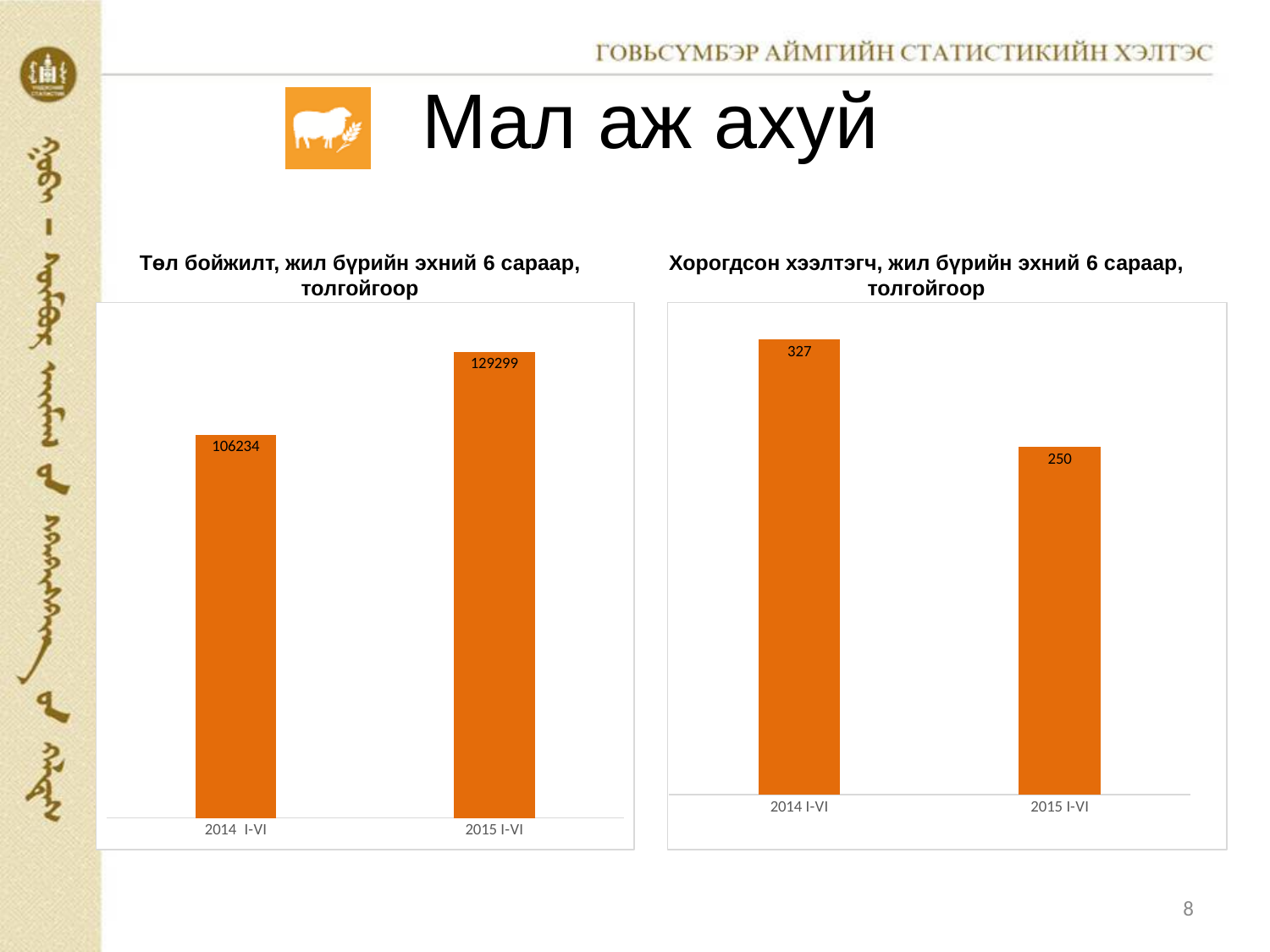
What type of chart is the left chart (Төл бойжилт)? bar chart In the left chart (Төл бойжилт), what is the value for 2014 I-VI? 106234 In the right chart (Хорогдсон хээлтэгч), what is the difference between the 2014 I-VI and 2015 I-VI values? 77 In the left chart (Төл бойжилт), what is the difference between the 2015 I-VI and 2014 I-VI values? 23065 In the right chart (Хорогдсон хээлтэгч), what is the value for 2014 I-VI? 327 In the left chart (Төл бойжилт), which period has the higher value? 2015 I-VI In the left chart (Төл бойжилт), do the values rise or fall from 2014 I-VI to 2015 I-VI? rise In the right chart (Хорогдсон хээлтэгч), do the values rise or fall from 2014 I-VI to 2015 I-VI? fall How many bars are shown in the right chart (Хорогдсон хээлтэгч)? 2 In the right chart (Хорогдсон хээлтэгч), which period has the lower value? 2015 I-VI In the left chart (Төл бойжилт), what is the value for 2015 I-VI? 129299 In the right chart (Хорогдсон хээлтэгч), what is the value for 2015 I-VI? 250